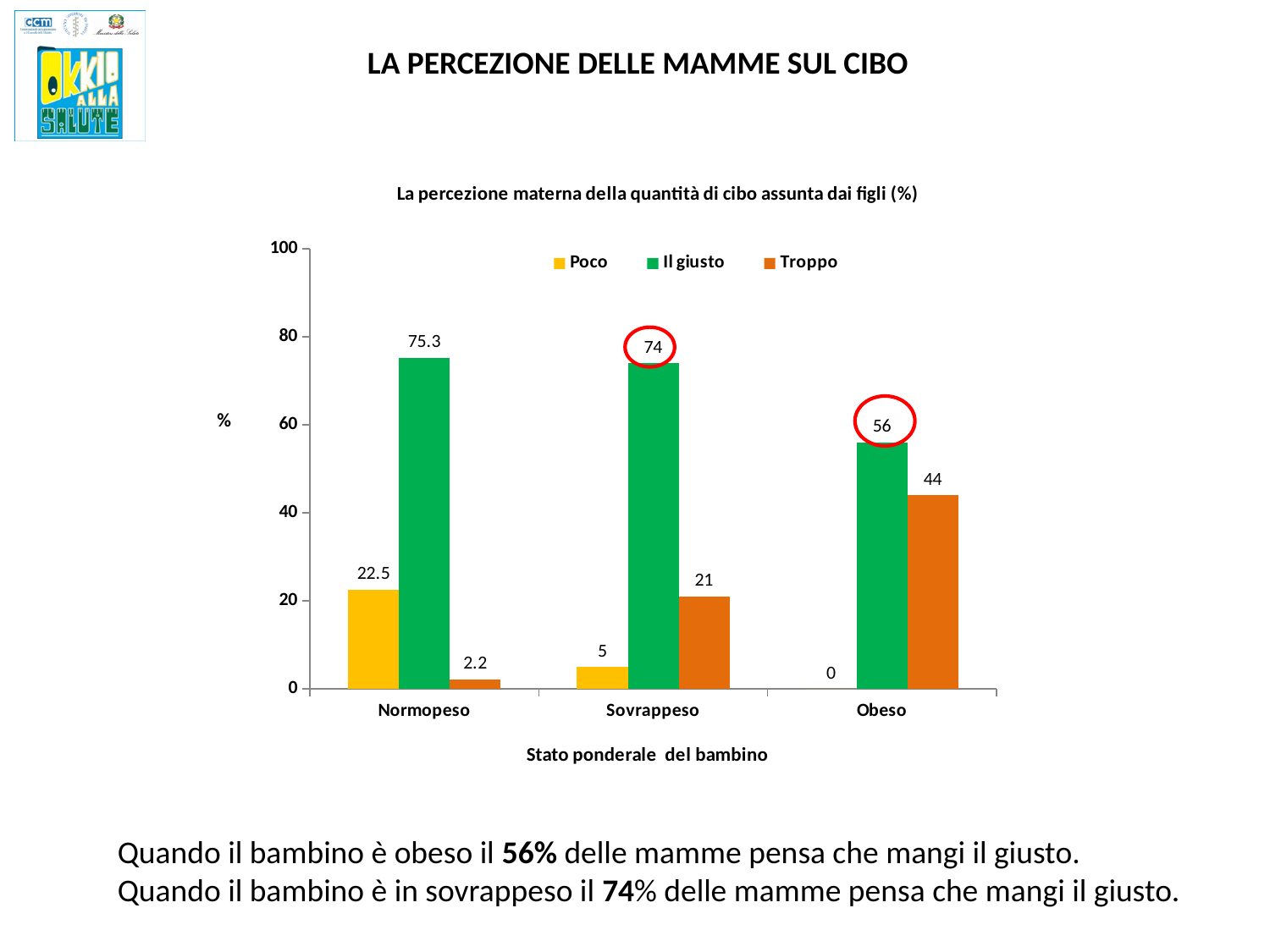
What is the value for 'Troppo' in the Obeso category? 44 What is the label of the x axis? Stato ponderale del bambino What is the difference between the 'Il giusto' values for Sovrappeso and Obeso? 18 What is the value for 'Troppo' in the Normopeso category? 2.2 How many categories are shown on the x axis? 3 Which is larger: 'Troppo' for Sovrappeso or 'Troppo' for Obeso? Troppo for Obeso Which category has the highest value for 'Poco'? Normopeso What is the value for 'Poco' in the Sovrappeso category? 5 How many series does the legend list? 3 Which category has the lowest value for 'Il giusto'? Obeso What is the value for 'Il giusto' in the Normopeso category? 75.3 What kind of chart is shown on the slide? Bar chart